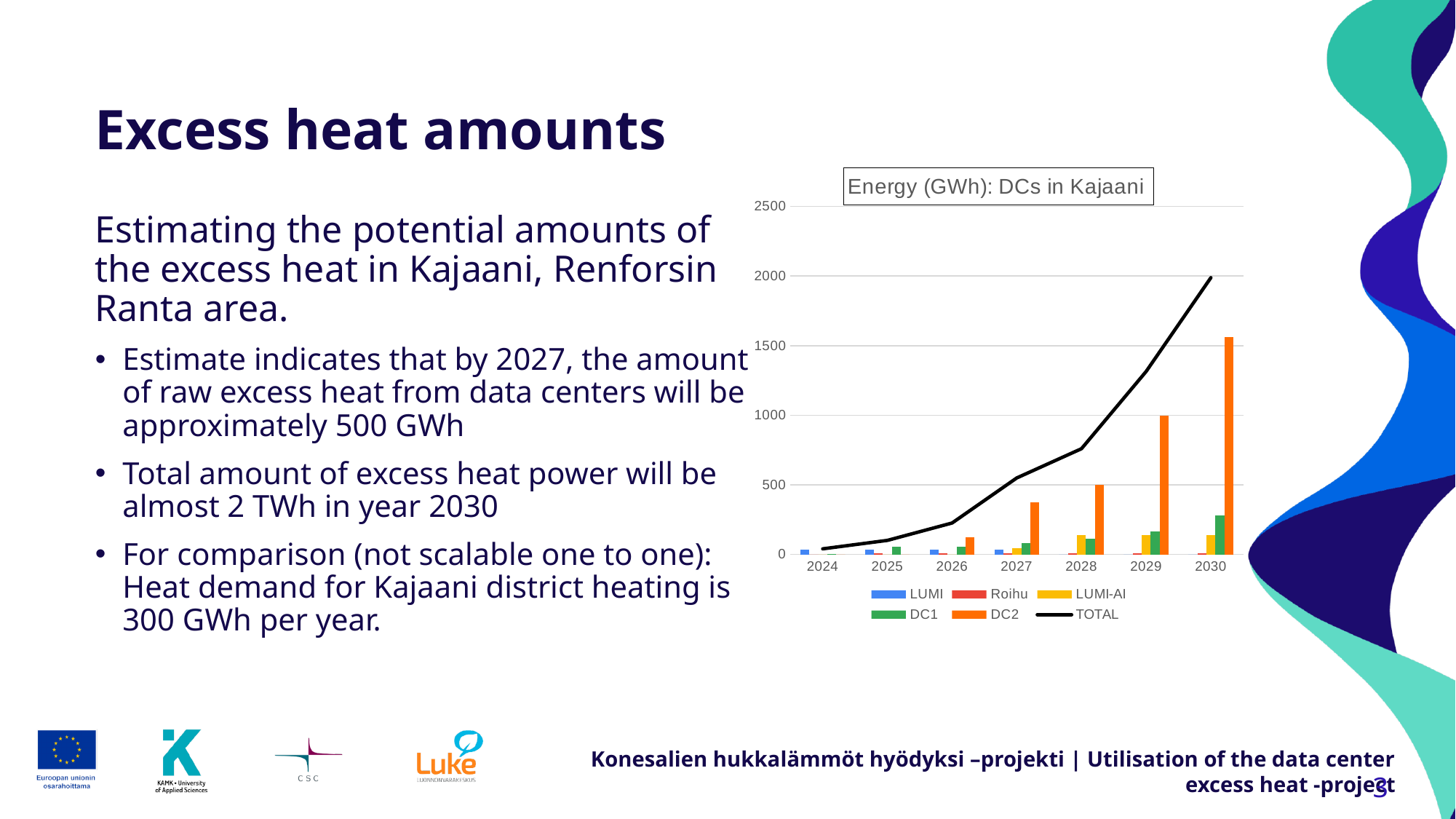
In which year is the DC2 bar the tallest? 2030 In which year is the TOTAL value lowest? 2024 Which series has the tallest bar in 2030? DC2 Is the TOTAL value for 2028 greater or less than 500? greater Is the TOTAL value for 2029 greater or less than 1000? greater What is the title of the chart? Energy (GWh): DCs in Kajaani In 2030, which is larger, the DC2 bar or the DC1 bar? DC2 How many series does the chart legend list? 6 Which series is drawn as a line rather than bars in the chart? TOTAL Does the TOTAL line rise or fall from 2024 to 2030? rises How many years are shown on the x axis of the chart? 7 Is the DC2 value for 2027 greater or less than 500? less